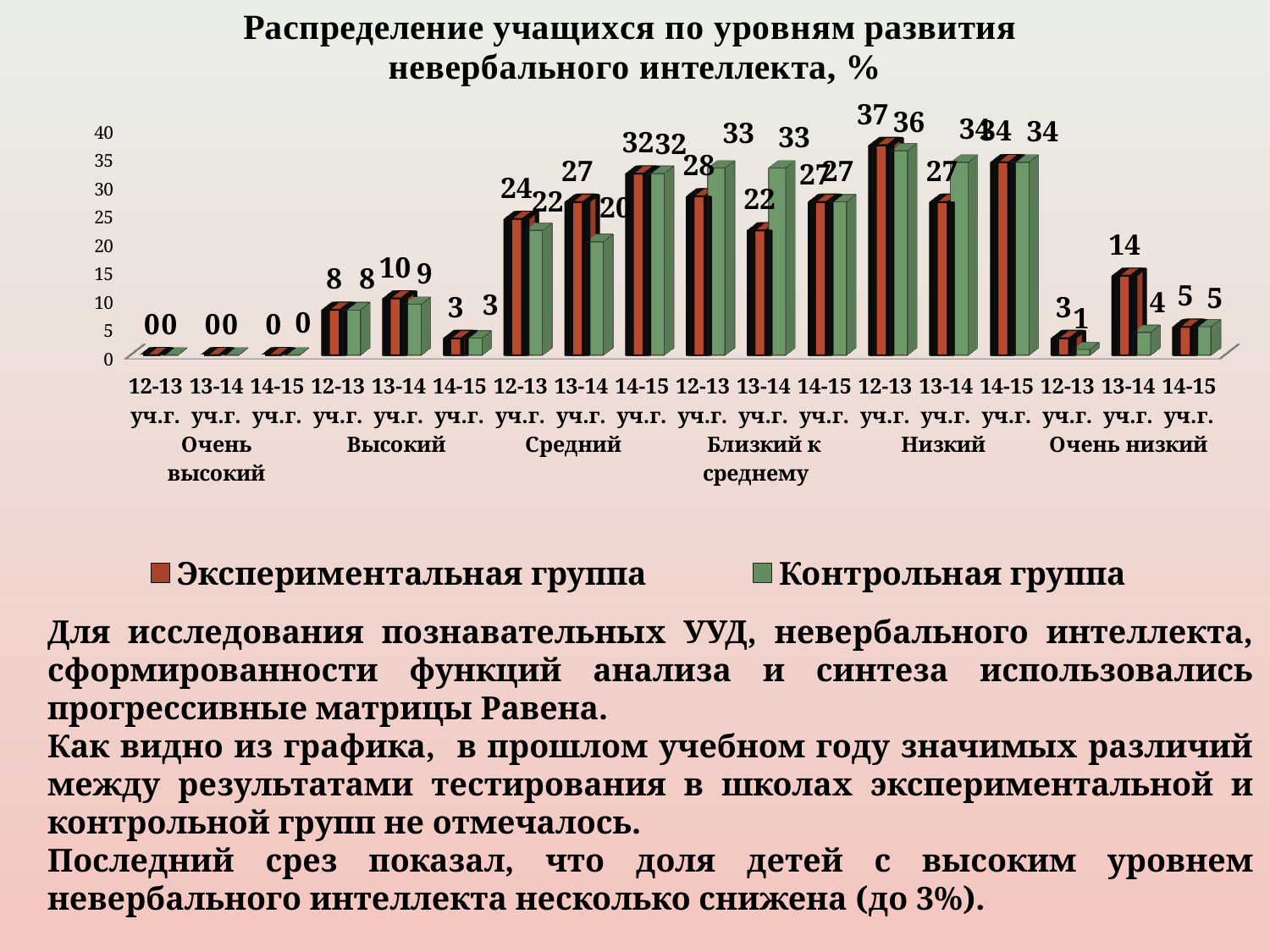
What is the difference between the Экспериментальная группа values for 13-14 уч.г. and 14-15 уч.г. in the Очень низкий category? 9 What is the title of the chart? Распределение учащихся по уровням развития невербального интеллекта, % What kind of chart is shown on the slide? Bar chart What is the value for the Контрольная группа in the 13-14 уч.г. Средний category? 20 What is the difference between the Контрольная группа and the Экспериментальная группа in the 13-14 уч.г. Близкий к среднему category? 11 In which category does the Экспериментальная группа reach its highest value? 12-13 уч.г. Низкий What is the value for the Экспериментальная группа in the 13-14 уч.г. Очень низкий category? 14 How many series does the legend list? 2 Which is larger in the 13-14 уч.г. Низкий category: the Экспериментальная группа or the Контрольная группа? Контрольная группа What is the value for both groups in the 14-15 уч.г. Высокий category? 3 How many categories (year-level groups) are shown on the x axis? 18 What is the value for the Экспериментальная группа in the 12-13 уч.г. Низкий category? 37